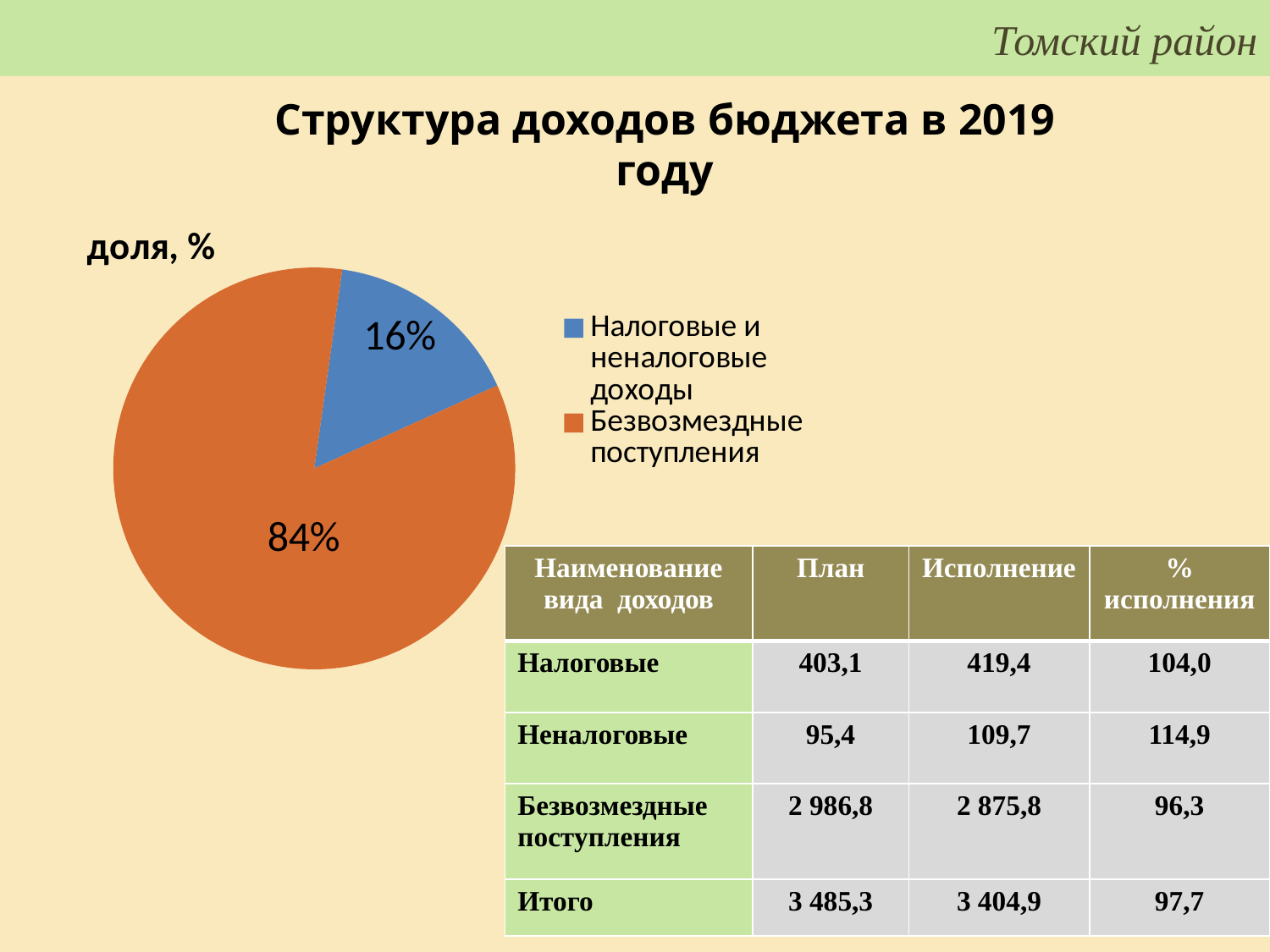
What is the title of the pie chart? доля, % What share of the pie does "Налоговые и неналоговые доходы" have? 16% What share of the pie does "Безвозмездные поступления" have? 84% What colour is the "Безвозмездные поступления" slice in the pie chart? orange What is the difference in percentage points between the "Безвозмездные поступления" slice and the "Налоговые и неналоговые доходы" slice? 68 How many slices does the pie chart have? 2 How many entries does the pie chart's legend list? 2 Which slice of the pie is the largest? Безвозмездные поступления Which is larger in the pie chart: "Налоговые и неналоговые доходы" or "Безвозмездные поступления"? Безвозмездные поступления Which slice of the pie is the smallest? Налоговые и неналоговые доходы What kind of chart is shown on the slide? pie chart